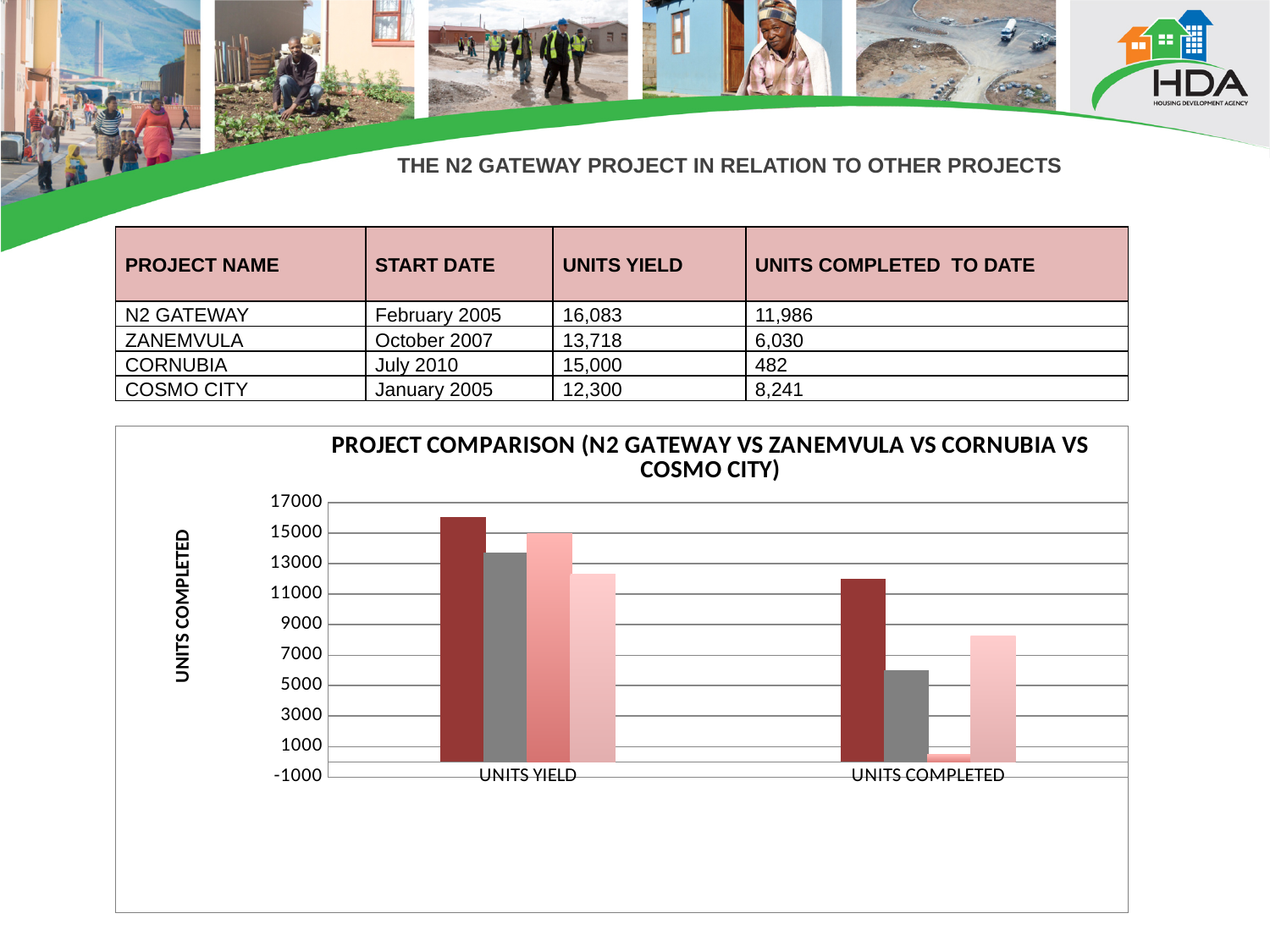
Is the shortest bar in the UNITS COMPLETED group greater or less than 1000? less What are the two categories on the x axis of the chart? UNITS YIELD and UNITS COMPLETED What is the title of the chart's vertical axis? UNITS COMPLETED Is the tallest bar in the UNITS YIELD group greater or less than 15000? greater What is the highest value shown on the chart's vertical axis? 17000 How many categories are shown on the x axis of the chart? 2 Is the dark red bar in the UNITS COMPLETED group greater or less than 5000? greater Which category group has the taller bars overall, UNITS YIELD or UNITS COMPLETED? UNITS YIELD What kind of chart is shown on the slide? bar chart How many bars are plotted in each category group of the chart? 4